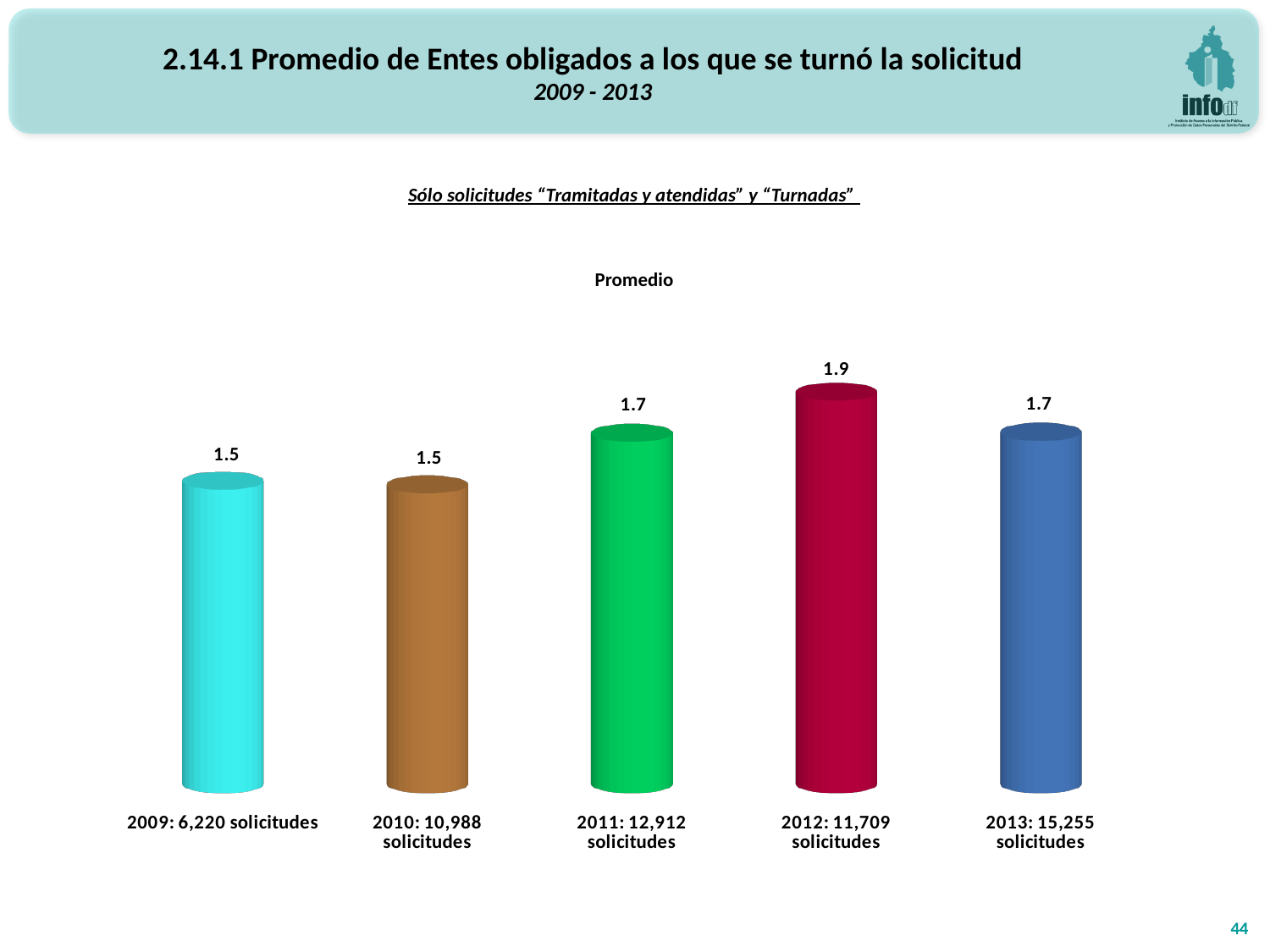
What is the title of the chart? Promedio Which is larger, the average value for 2011 or for 2010? 2011 What kind of chart is shown on the slide? Bar chart How many solicitudes are indicated in the category label for 2013? 15,255 What is the average (Promedio) value shown for 2009? 1.5 What is the average value shown for 2012? 1.9 How many years (bars) are plotted in the chart? 5 What colour is the bar for 2012? Red What is the average value shown for 2013? 1.7 What is the difference between the average values for 2011 and 2009? 0.2 What is the difference between the average values for 2012 and 2010? 0.4 Which year has the highest average value? 2012